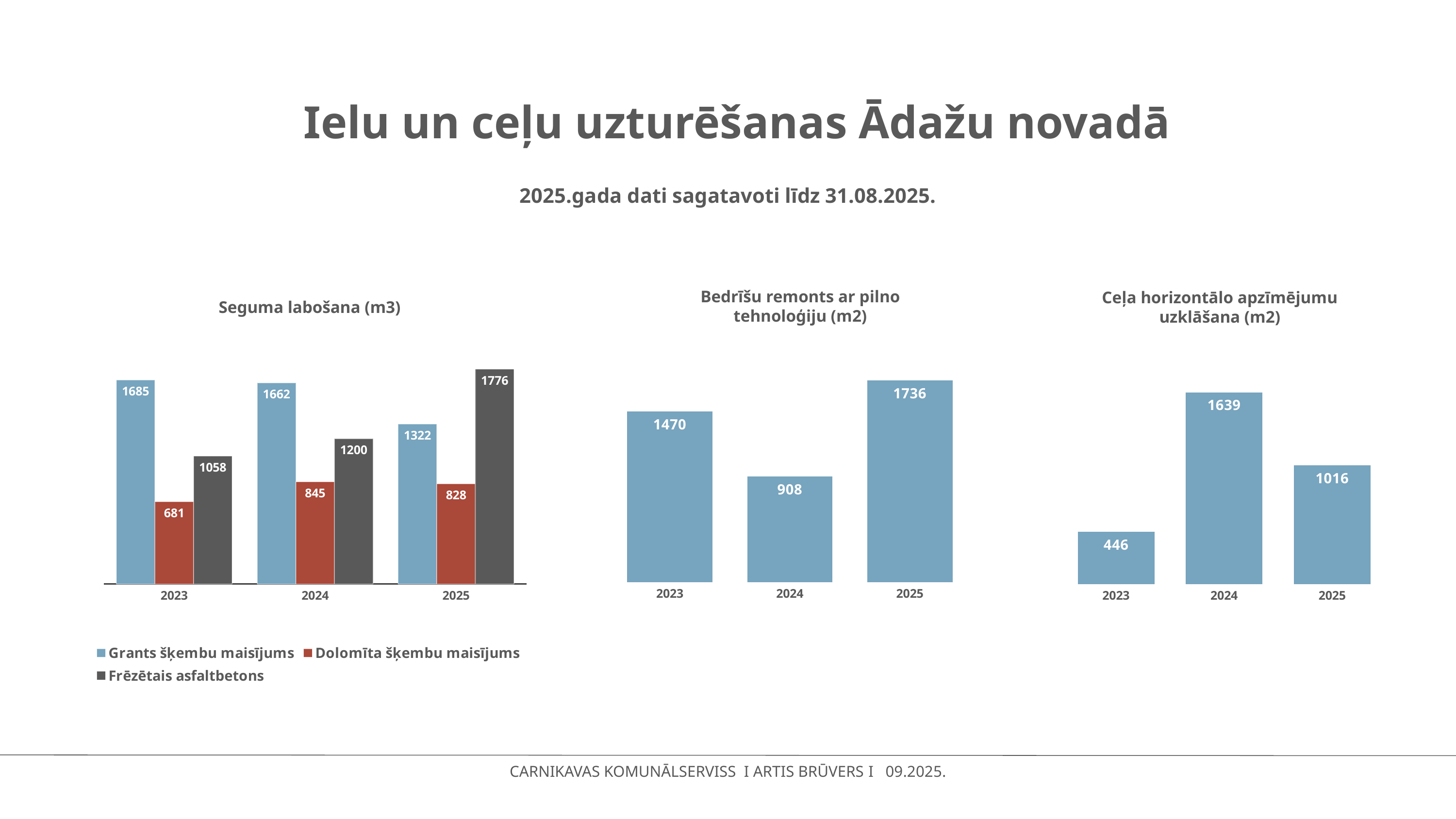
In the 'Seguma labošana (m3)' chart, what is the difference between Grants šķembu maisījums and Dolomīta šķembu maisījums in 2025? 494 In the 'Seguma labošana (m3)' chart, which series has the highest value in 2025? Frēzētais asfaltbetons In the 'Seguma labošana (m3)' chart, what is the value for Frēzētais asfaltbetons in 2025? 1776 In the 'Seguma labošana (m3)' chart, what is the value for Grants šķembu maisījums in 2023? 1685 What kind of chart is the 'Ceļa horizontālo apzīmējumu uzklāšana (m2)' chart? Bar chart In the 'Seguma labošana (m3)' chart, what is the value for Dolomīta šķembu maisījums in 2024? 845 In the 'Ceļa horizontālo apzīmējumu uzklāšana (m2)' chart, what is the value for 2024? 1639 In the 'Bedrīšu remonts ar pilno tehnoloģiju (m2)' chart, what is the difference between 2025 and 2023? 266 In the 'Bedrīšu remonts ar pilno tehnoloģiju (m2)' chart, what is the value for 2024? 908 In the 'Seguma labošana (m3)' chart, how many series does the legend list? 3 In the 'Bedrīšu remonts ar pilno tehnoloģiju (m2)' chart, which year has the highest value? 2025 In the 'Ceļa horizontālo apzīmējumu uzklāšana (m2)' chart, which year has the lowest value? 2023